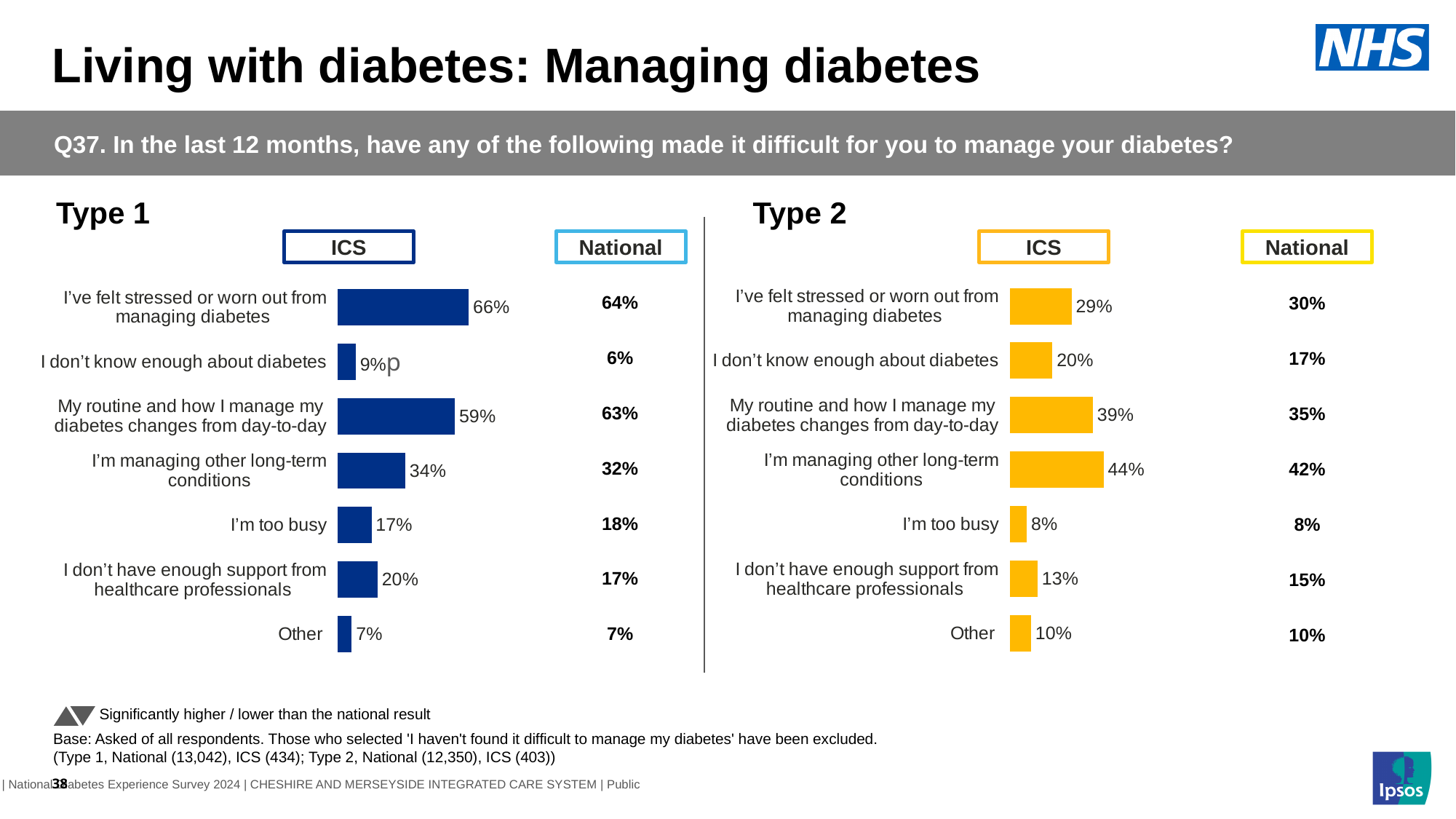
In the Type 1 chart, what is the National value for 'I don't know enough about diabetes'? 6% In the Type 1 chart, which category has the highest ICS value? I've felt stressed or worn out from managing diabetes What kind of chart is used to show the ICS values in the Type 1 chart? Bar chart In the Type 1 chart, what is the difference between the ICS and National values for 'My routine and how I manage my diabetes changes from day-to-day'? 4 percentage points In the Type 2 chart, what is the ICS value for 'Other'? 10% How many categories are shown in the Type 2 chart? 7 In the Type 2 chart, what is the ICS value for 'I'm managing other long-term conditions'? 44% In the Type 1 chart, what is the ICS value for 'I've felt stressed or worn out from managing diabetes'? 66% In the Type 2 chart, what is the National value for 'My routine and how I manage my diabetes changes from day-to-day'? 35% In the Type 2 chart, which category has the lowest ICS value? I'm too busy In the Type 2 chart, which is larger for 'I don't know enough about diabetes': the ICS value or the National value? ICS In the Type 1 chart, which is larger for 'I'm too busy': the ICS value or the National value? National